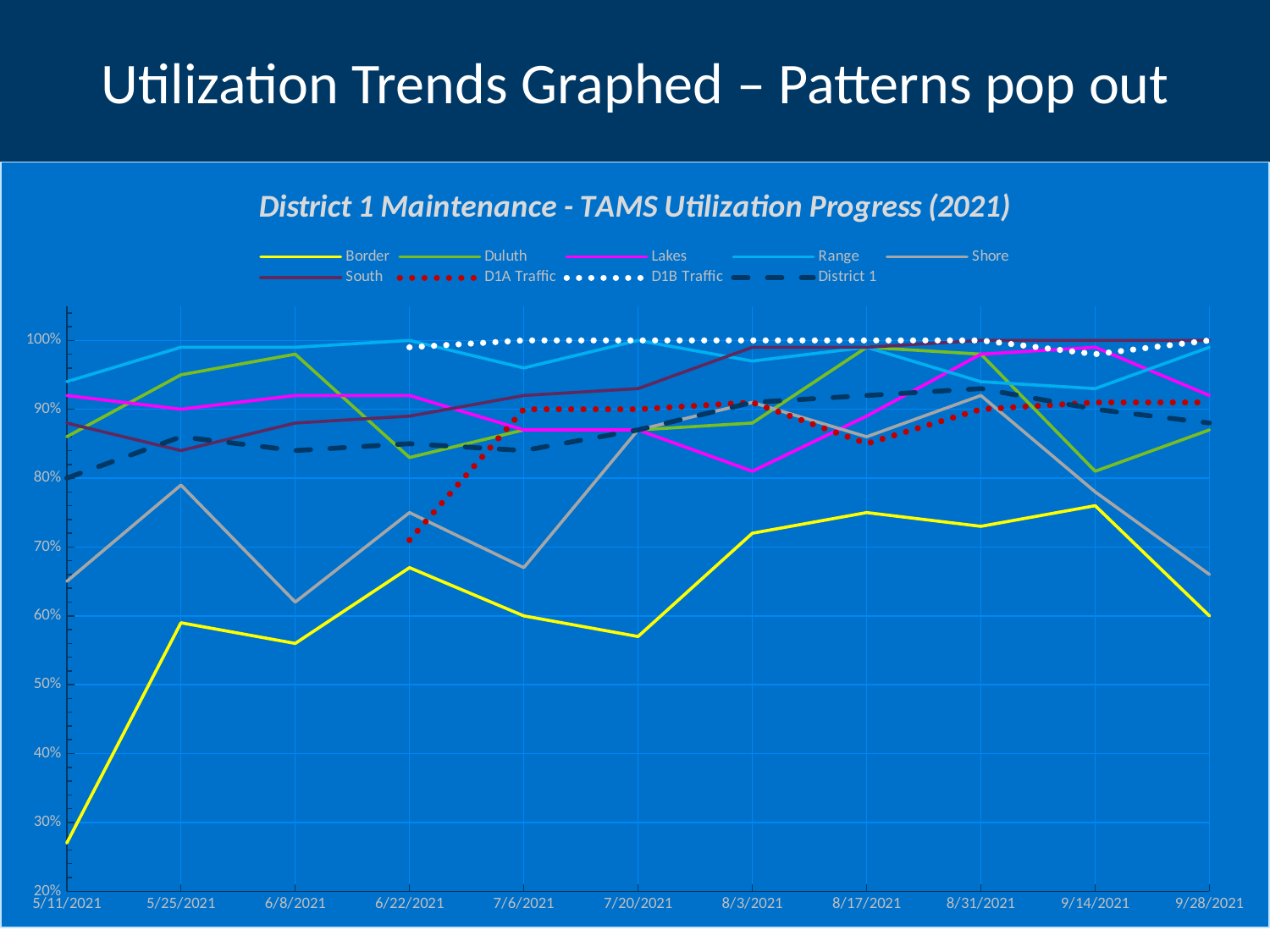
What is the title of the chart? District 1 Maintenance - TAMS Utilization Progress (2021) Which series has the lowest value on 5/11/2021? Border Is the value for Border on 5/11/2021 greater or less than 30%? less Does the Border line rise or fall from 5/11/2021 to 5/25/2021? rise How many dates are shown along the x axis? 11 Which series has the lowest value on 9/28/2021? Border On 5/25/2021, which is larger, Border or Shore? Shore Does the Shore line rise or fall from 8/31/2021 to 9/28/2021? fall What kind of chart is shown on the slide? line chart How many series does the legend list? 9 Is the value for Border on 8/17/2021 greater or less than 70%? greater Is the value for Shore on 9/28/2021 greater or less than 60%? greater